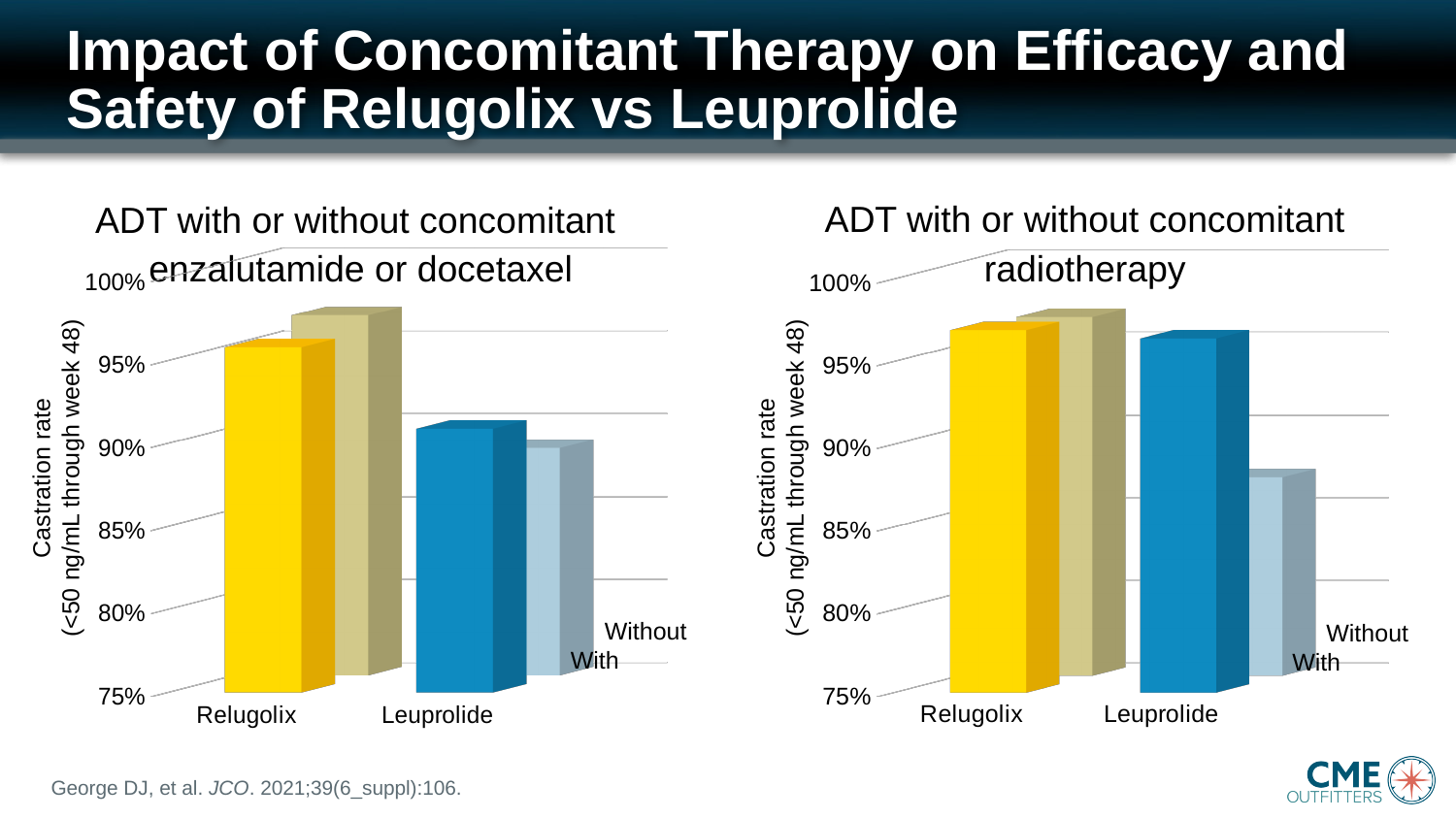
In the right chart (ADT with or without concomitant radiotherapy), is the castration rate for Relugolix 'With' greater or less than 95%? greater How many categories are shown on the x axis of the right chart (ADT with or without concomitant radiotherapy)? 2 In the right chart (ADT with or without concomitant radiotherapy), is the castration rate for Leuprolide 'Without' greater or less than 90%? less What type of chart is used on the left chart (ADT with or without concomitant enzalutamide or docetaxel)? Bar chart How many series (With / Without) are plotted in the left chart (ADT with or without concomitant enzalutamide or docetaxel)? 2 In the right chart (ADT with or without concomitant radiotherapy), which Leuprolide bar is higher, 'With' or 'Without'? With In the left chart (ADT with or without concomitant enzalutamide or docetaxel), is the castration rate for Relugolix 'With' greater or less than 95%? greater In the left chart (ADT with or without concomitant enzalutamide or docetaxel), which treatment has the highest castration rate? Relugolix What is the y-axis label of the right chart (ADT with or without concomitant radiotherapy)? Castration rate (<50 ng/mL through week 48) In the right chart (ADT with or without concomitant radiotherapy), which bar shows the lowest castration rate? Leuprolide Without In the left chart (ADT with or without concomitant enzalutamide or docetaxel), which has the higher castration rate in the 'With' series, Relugolix or Leuprolide? Relugolix